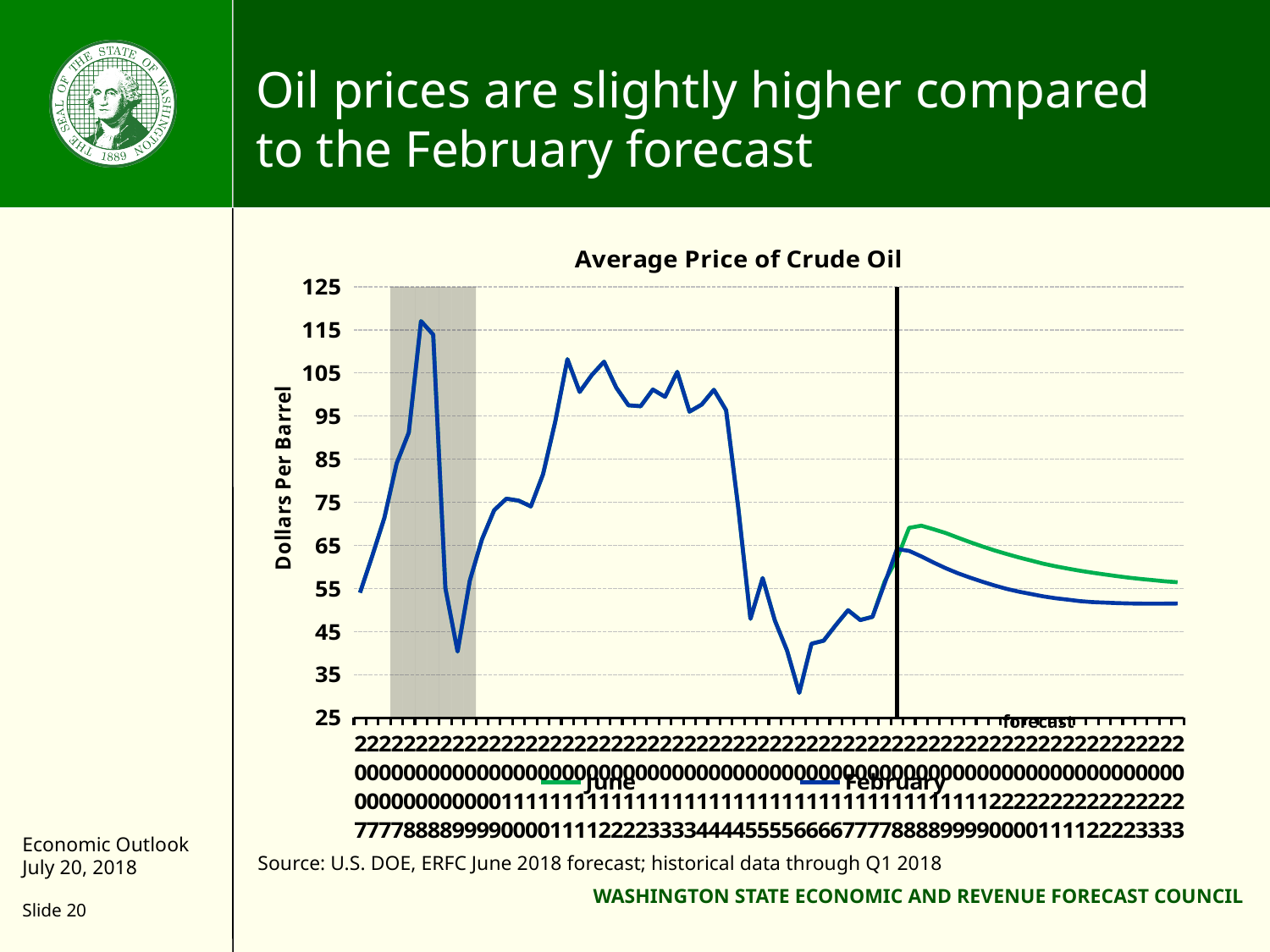
What is the highest value shown on the vertical axis of the chart? 125 What is the title of the chart? Average Price of Crude Oil At the right end of the forecast period, is the June line greater or less than 55 dollars per barrel? greater Is the lowest value of the blue February line greater or less than 35 dollars per barrel? less What is the label on the vertical axis of the chart? Dollars Per Barrel In the forecast period, which series shows the higher oil price, June or February? June How many series does the chart's legend list? 2 At the right end of the forecast period, is the February line greater or less than 55 dollars per barrel? less What kind of chart is shown on the slide? line chart Over the forecast period, does the February line rise or fall? fall